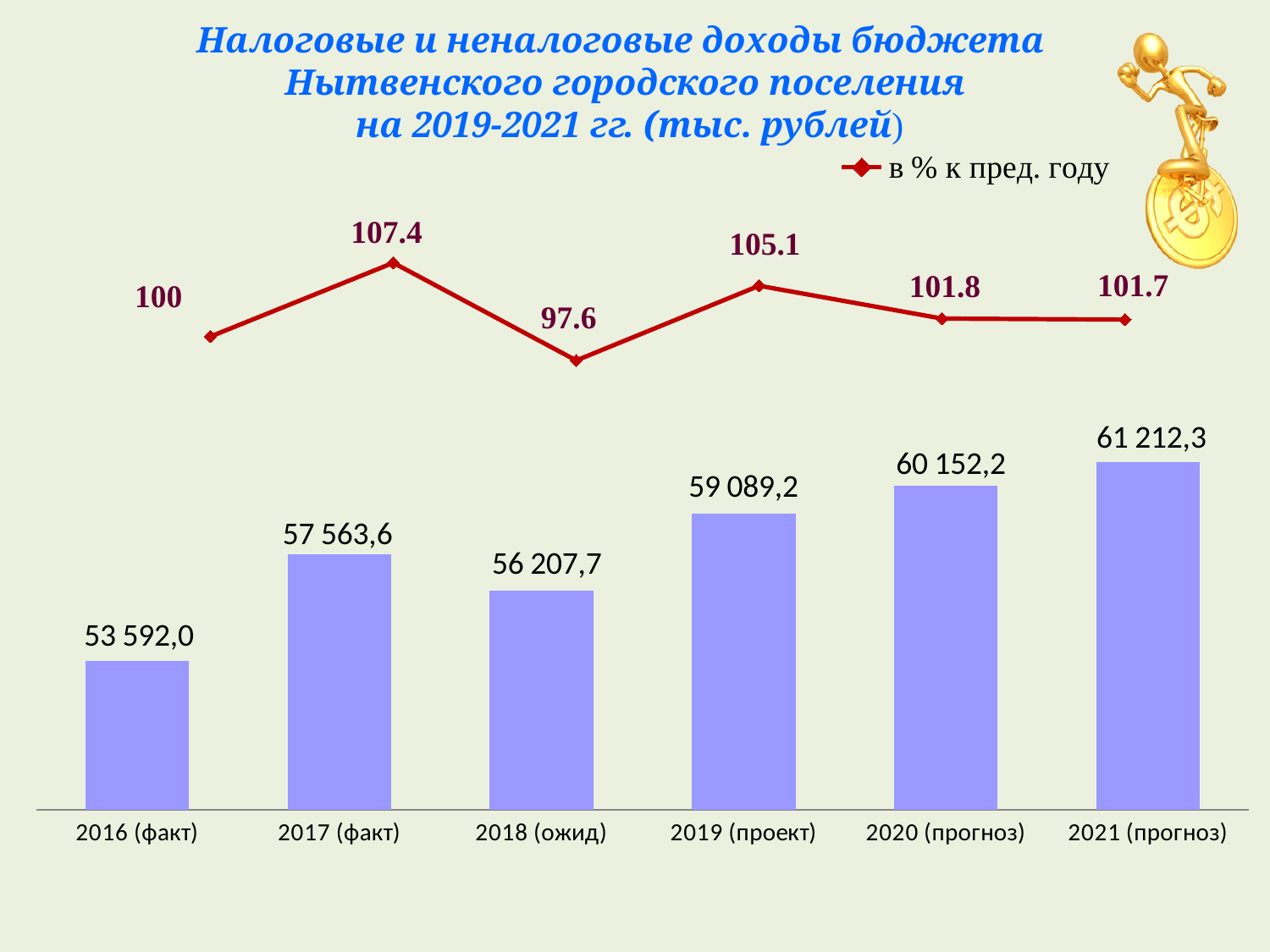
What is the value of the line series 'в % к пред. году' for 2017 (факт)? 107.4 What is the difference between the bar values for 2021 (прогноз) and 2016 (факт)? 7 620,3 What is the difference between the line values for 2017 (факт) and 2018 (ожид)? 9.8 Which category has the highest bar value? 2021 (прогноз) Which has the larger bar value, 2017 (факт) or 2018 (ожид)? 2017 (факт) Which category has the lowest value on the line series 'в % к пред. году'? 2018 (ожид) How many categories are shown on the x axis? 6 What is the value of the line series 'в % к пред. году' for 2018 (ожид)? 97.6 What is the bar value for 2016 (факт)? 53 592,0 What is the bar value for 2019 (проект)? 59 089,2 What is the name of the series shown in the legend? в % к пред. году How many series does the legend list? 1